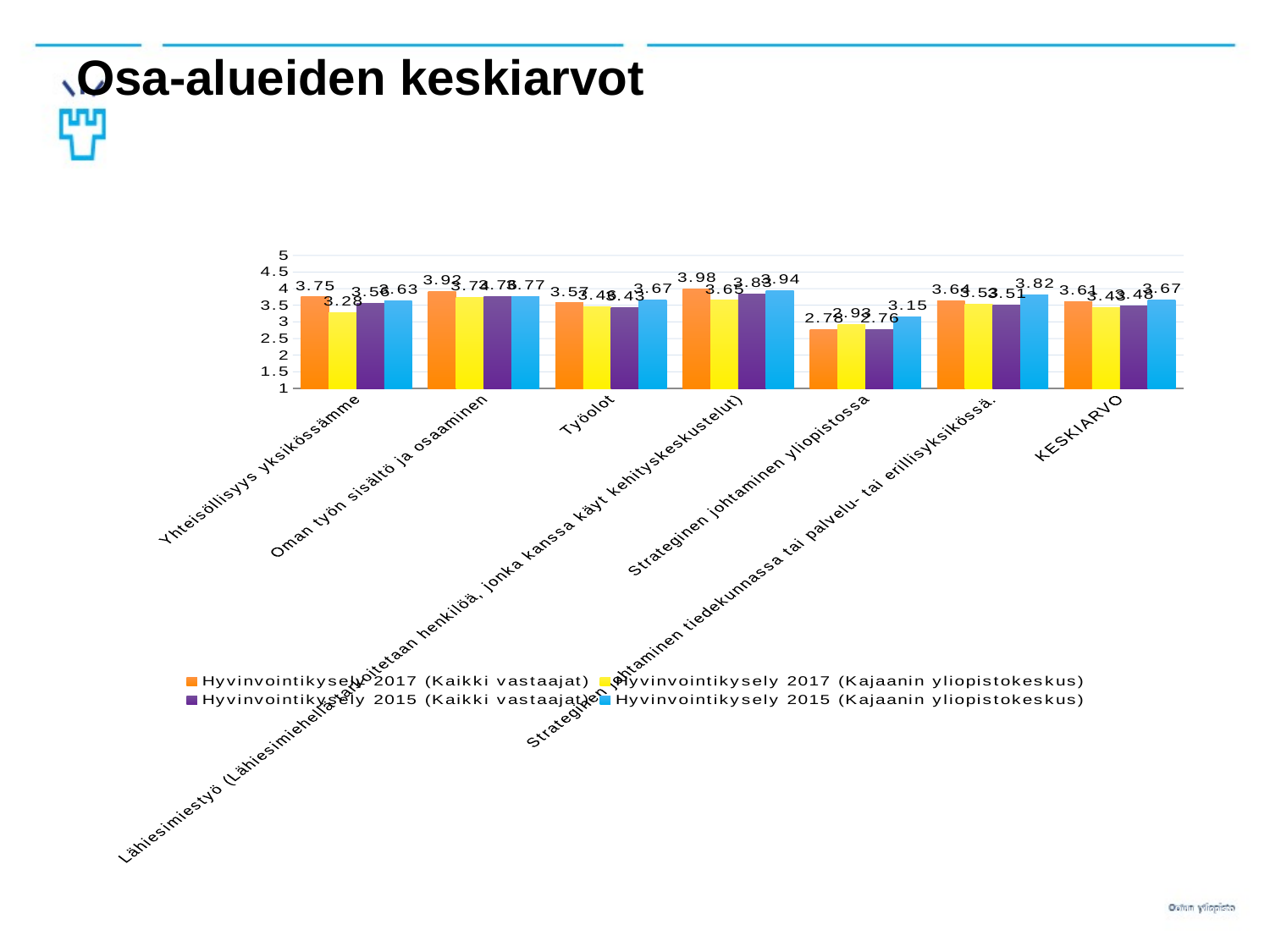
What kind of chart is shown on the slide? bar chart What is the difference between the Hyvinvointikysely 2017 (Kaikki vastaajat) and Hyvinvointikysely 2017 (Kajaanin yliopistokeskus) values for Lähiesimiestyö? 0.33 What is the value for Oman työn sisältö ja osaaminen in the Hyvinvointikysely 2017 (Kaikki vastaajat) series? 3.92 What is the value for Yhteisöllisyys yksikössämme in the Hyvinvointikysely 2017 (Kaikki vastaajat) series? 3.75 Which category has the lowest values across all series? Strateginen johtaminen yliopistossa For Yhteisöllisyys yksikössämme, which is larger: the Hyvinvointikysely 2017 (Kaikki vastaajat) value or the Hyvinvointikysely 2017 (Kajaanin yliopistokeskus) value? Hyvinvointikysely 2017 (Kaikki vastaajat) What is the KESKIARVO value for the Hyvinvointikysely 2015 (Kajaanin yliopistokeskus) series? 3.67 How many categories are shown on the x axis? 7 What is the value for Strateginen johtaminen yliopistossa in the Hyvinvointikysely 2015 (Kajaanin yliopistokeskus) series? 3.15 How many series does the legend list? 4 What is the value for Yhteisöllisyys yksikössämme in the Hyvinvointikysely 2017 (Kajaanin yliopistokeskus) series? 3.28 Is the value for Strateginen johtaminen yliopistossa in the Hyvinvointikysely 2017 (Kaikki vastaajat) series greater or less than 3? less